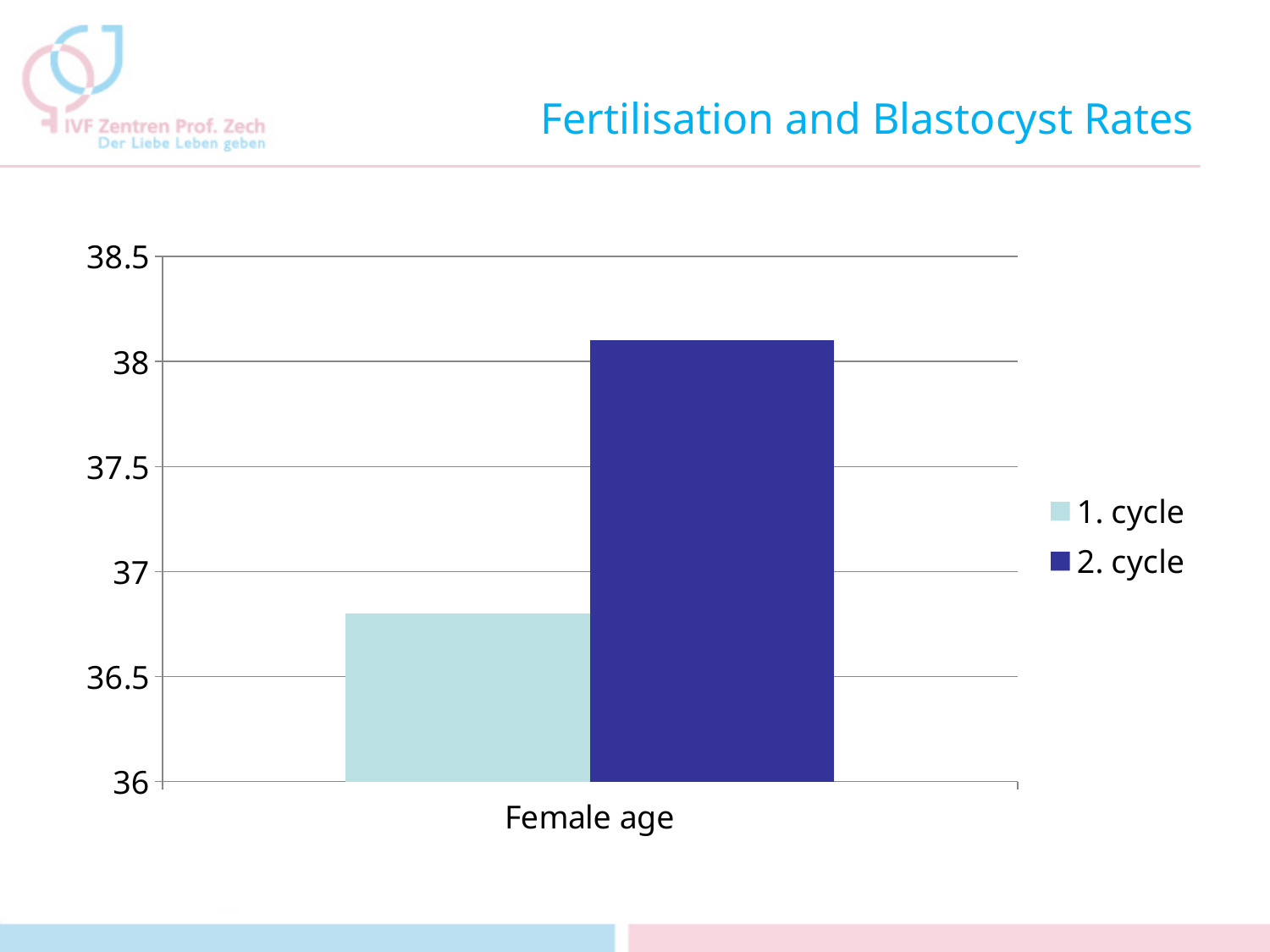
What is the title of the slide containing the chart? Fertilisation and Blastocyst Rates Is the value for 1. cycle greater or less than 36.5? greater Which series has the higher value for Female age, 1. cycle or 2. cycle? 2. cycle Which series has the lowest value for Female age? 1. cycle What kind of chart is shown on the slide? bar chart Is the value for 2. cycle greater or less than 38.5? less How many series does the legend list? 2 What is the label on the x axis of the chart? Female age Is the value for 1. cycle greater or less than 37? less How many categories are shown on the x axis? 1